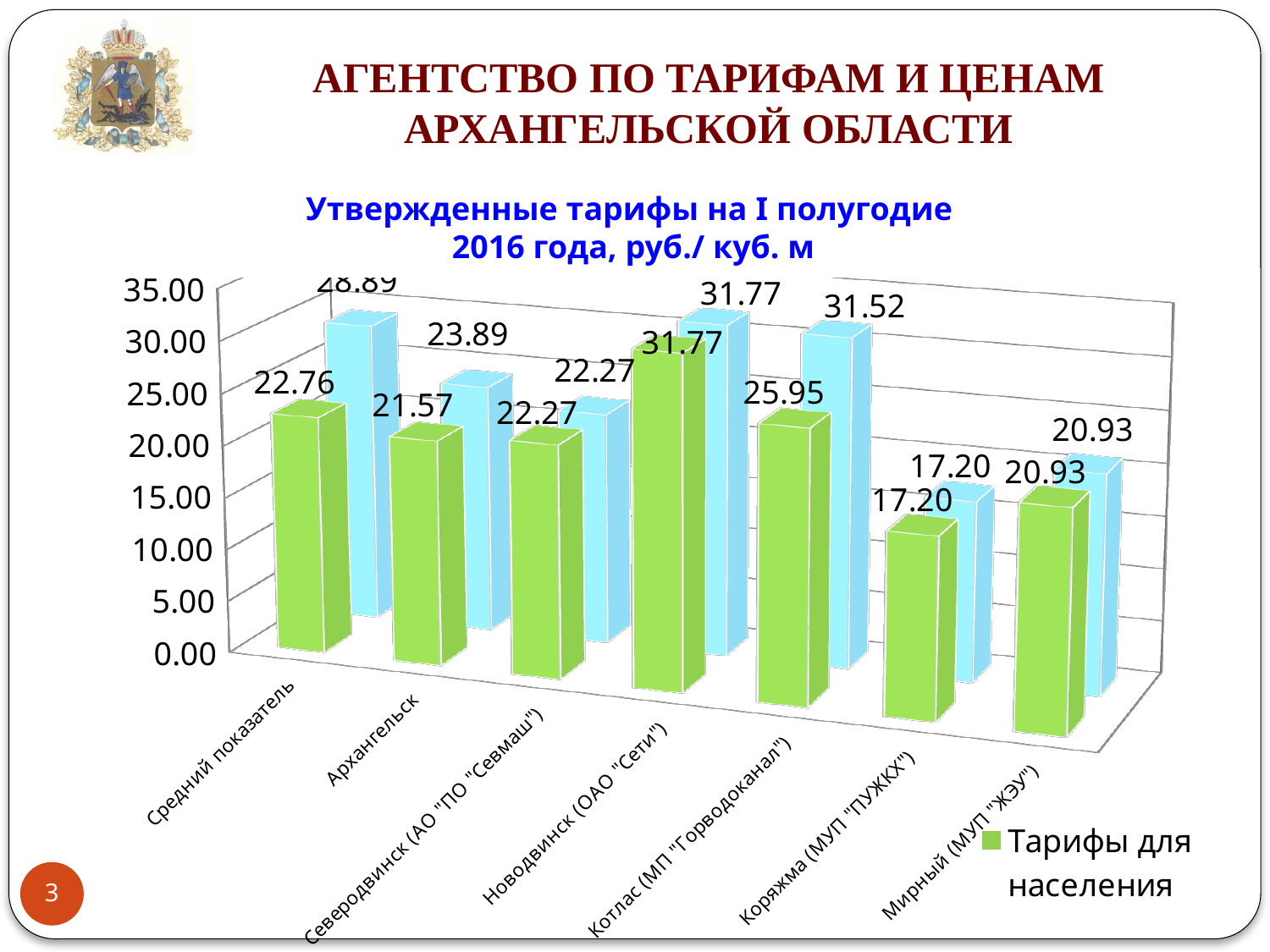
In the 'Тарифы для населения' series, what is the difference between Средний показатель and Архангельск? 1.19 In the 'Тарифы для населения' series, which is larger: Котлас (МП "Горводоканал") or Архангельск? Котлас (МП "Горводоканал") Which category has the highest value in the 'Тарифы для населения' series? Новодвинск (ОАО "Сети") Which category has the lowest value in the 'Тарифы для населения' series? Коряжма (МУП "ПУЖКХ") What is the value of the 'Тарифы для населения' series for Архангельск? 21.57 How many categories are shown on the x axis of the chart? 7 What is the value of the 'Тарифы для населения' series for Мирный (МУП "ЖЭУ")? 20.93 What type of chart is shown on the slide? Bar chart What is the value of the 'Тарифы для населения' series for Коряжма (МУП "ПУЖКХ")? 17.20 What is the value of the 'Тарифы для населения' series for Котлас (МП "Горводоканал")? 25.95 In the 'Тарифы для населения' series, what is the difference between the values for Новодвинск (ОАО "Сети") and Коряжма (МУП "ПУЖКХ")? 14.57 Is the 'Тарифы для населения' value for Новодвинск (ОАО "Сети") greater or less than 30.00? greater